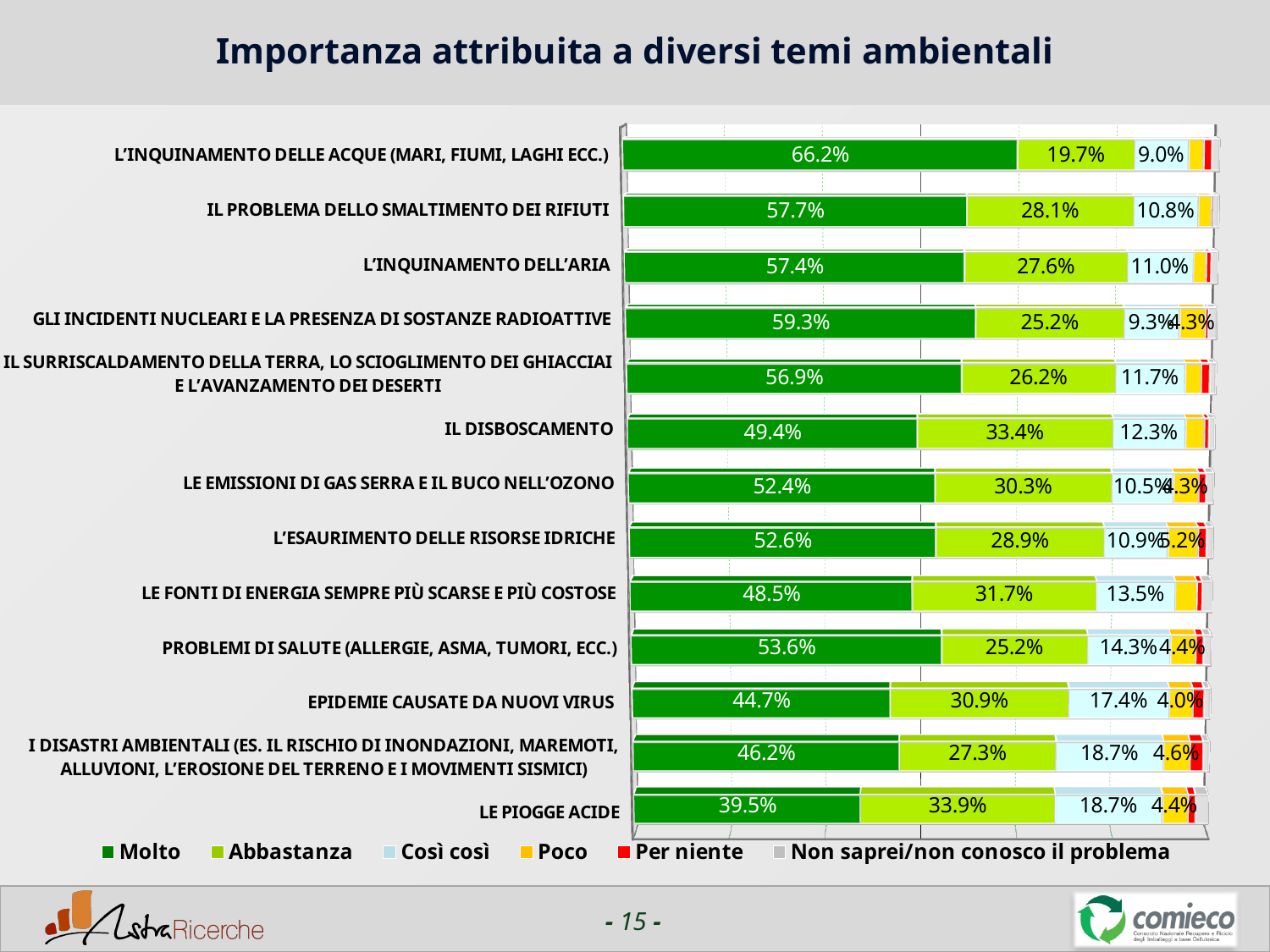
What is the difference between the "Molto" values for IL PROBLEMA DELLO SMALTIMENTO DEI RIFIUTI and LE PIOGGE ACIDE? 18.2% What is the "Così così" value for EPIDEMIE CAUSATE DA NUOVI VIRUS? 17.4% What is the "Abbastanza" value for IL DISBOSCAMENTO? 33.4% Which legend entry is shown in red? Per niente How many series does the legend list? 6 Which environmental theme has the lowest "Molto" percentage? LE PIOGGE ACIDE How many environmental themes are listed in the chart? 13 What percentage of respondents answered "Molto" for L'INQUINAMENTO DELLE ACQUE (MARI, FIUMI, LAGHI ECC.)? 66.2% What kind of chart is shown on the slide? Stacked bar chart What is the "Poco" value for L'ESAURIMENTO DELLE RISORSE IDRICHE? 5.2% Which has a larger "Abbastanza" value: LE FONTI DI ENERGIA SEMPRE PIÙ SCARSE E PIÙ COSTOSE or PROBLEMI DI SALUTE (ALLERGIE, ASMA, TUMORI, ECC.)? LE FONTI DI ENERGIA SEMPRE PIÙ SCARSE E PIÙ COSTOSE Which environmental theme has the highest "Molto" percentage? L'INQUINAMENTO DELLE ACQUE (MARI, FIUMI, LAGHI ECC.)